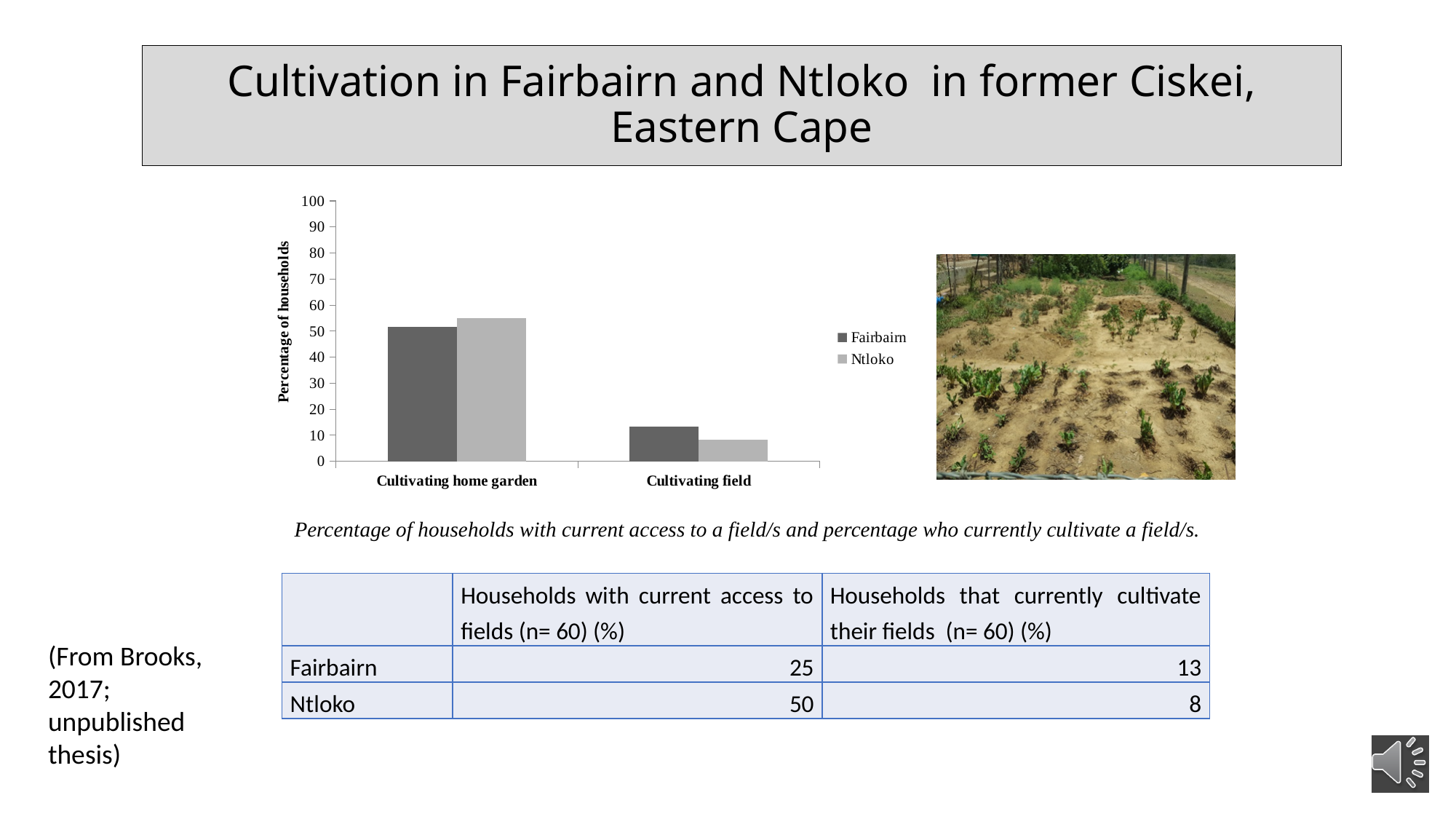
What kind of chart is shown on the slide? bar chart Which category has the lowest bar for Ntloko? Cultivating field How many categories are shown on the x axis of the chart? 2 Is the value for Fairbairn in the Cultivating field category greater or less than 20? less Is the value for Ntloko in the Cultivating field category greater or less than 10? less In the Cultivating field category, which series has the larger value, Fairbairn or Ntloko? Fairbairn Is the value for Ntloko in the Cultivating home garden category greater or less than 60? less Which two series are listed in the chart legend? Fairbairn and Ntloko How many series does the chart legend list? 2 For Fairbairn, which category has the higher value, Cultivating home garden or Cultivating field? Cultivating home garden What is the label of the chart's y axis? Percentage of households